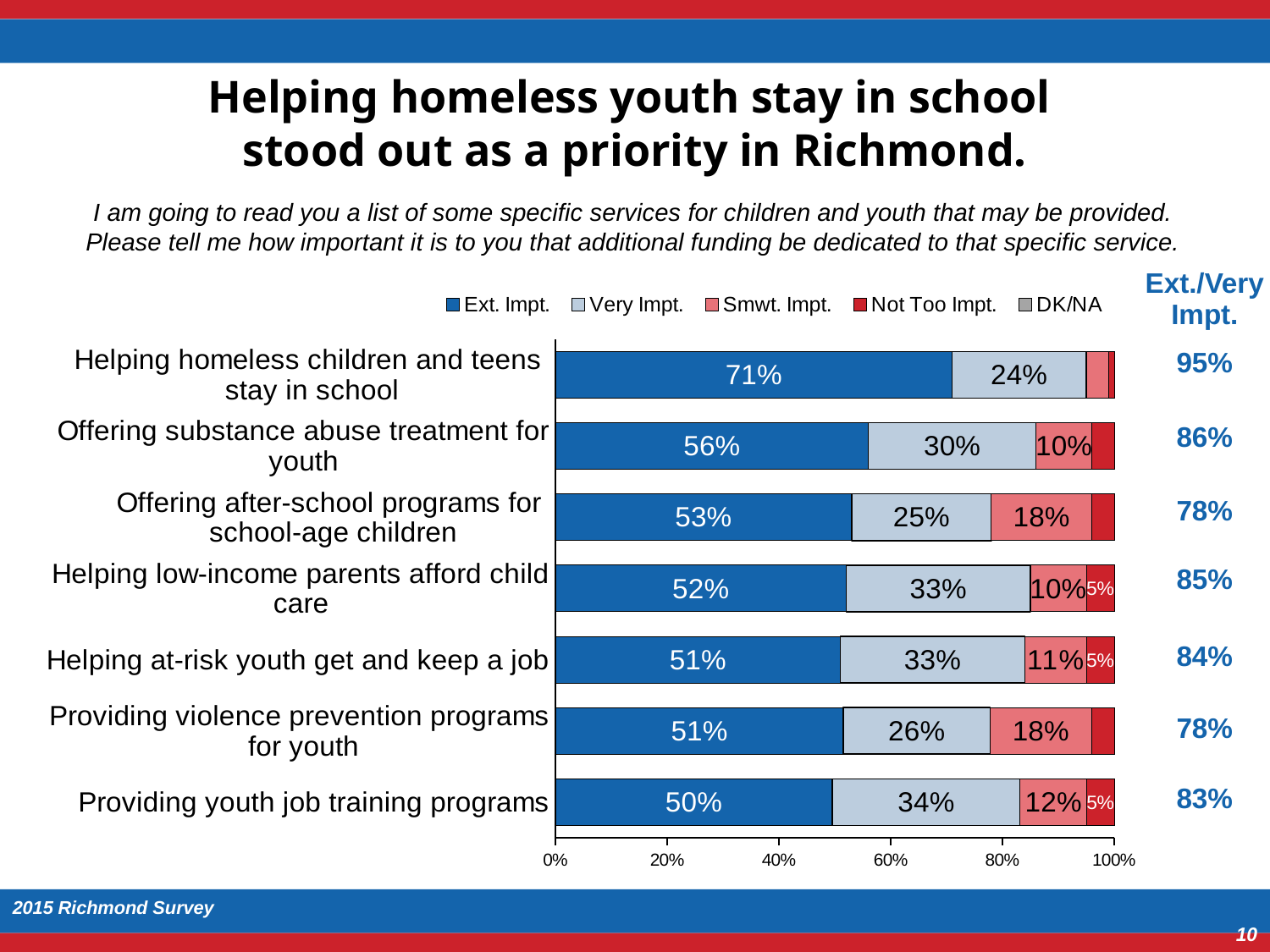
What type of chart is shown on the slide? Stacked bar chart What is the combined Ext./Very Impt. figure shown for 'Offering substance abuse treatment for youth'? 86% Which service has the highest Ext. Impt. percentage? Helping homeless children and teens stay in school What percentage rated 'Helping homeless children and teens stay in school' as Ext. Impt.? 71% Which has a larger Very Impt. value: 'Helping low-income parents afford child care' or 'Offering after-school programs for school-age children'? Helping low-income parents afford child care Which service has the lowest Ext. Impt. percentage? Providing youth job training programs How many services are listed in the chart? 7 What is the Smwt. Impt. value for 'Offering after-school programs for school-age children'? 18% What is the first entry in the chart's legend? Ext. Impt. What is the difference in Ext. Impt. percentage between 'Helping homeless children and teens stay in school' and 'Offering substance abuse treatment for youth'? 15 percentage points What is the Very Impt. value for 'Providing youth job training programs'? 34% How many series does the legend list? 5